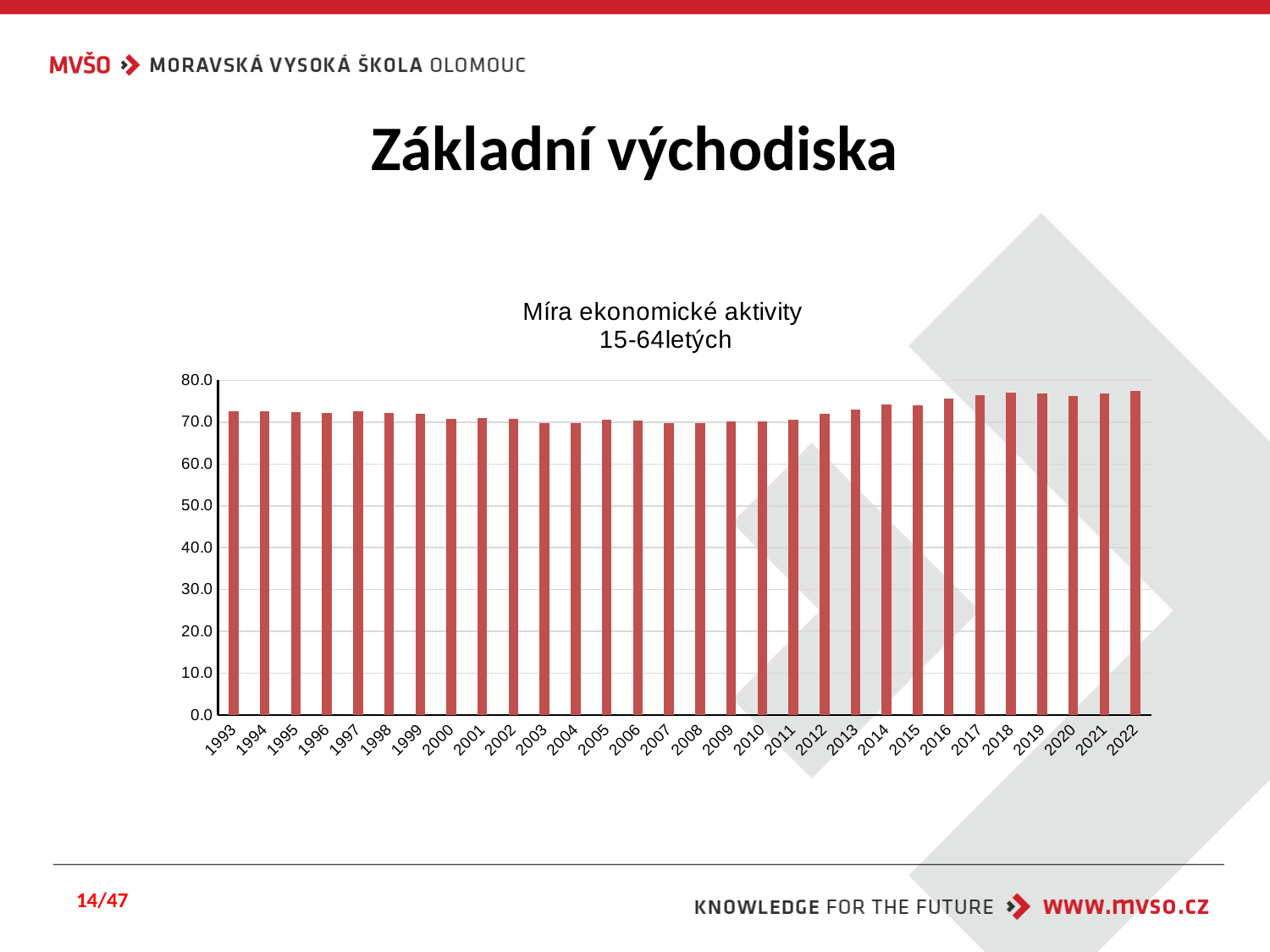
What kind of chart is shown on the slide? bar chart Which year has the larger value, 2007 or 2021? 2021 Is the value for 2022 greater or less than 70? greater Is the value for 2018 greater or less than 80? less How many years (bars) are plotted on the chart? 30 Which is the first year shown on the x axis of the chart? 1993 Is the value for 2005 greater or less than 80? less Do the values rise or fall from 2013 to 2022? rise Which year has the larger value, 2022 or 2009? 2022 Which year has the larger value, 2004 or 2018? 2018 What is the title of the chart? Míra ekonomické aktivity 15-64letých